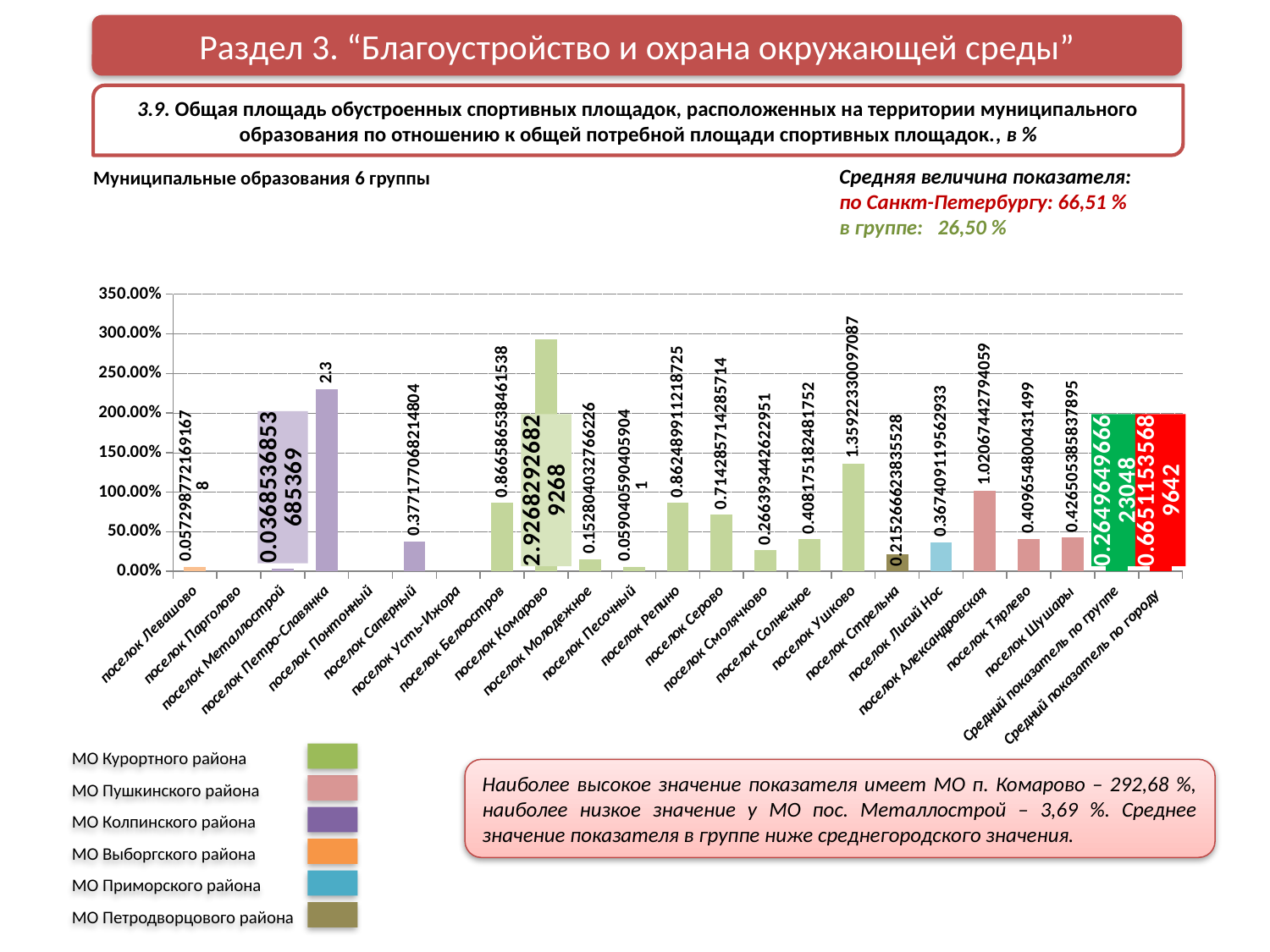
Which is larger, the value for поселок Петро-Славянка or the value for поселок Белоостров? поселок Петро-Славянка What data label is printed on the bar for поселок Петро-Славянка? 2.3 What data label is printed on the bar for поселок Ушково? 1.35922330097087 Which is larger, the value for поселок Ушково or the value for поселок Александровская? поселок Ушково How many district groups are listed in the colour legend below the chart? 6 Is the value for поселок Саперный greater or less than 50.00%? less What kind of chart is shown on the slide? bar chart How many categories are labelled along the x axis of the chart? 23 Which category has the highest bar in the chart? поселок Комарово Is the value for поселок Комарово greater or less than 250.00%? greater What data label is printed on the bar for поселок Саперный? 0.377177068214804 What data label is printed on the bar for поселок Серово? 0.714285714285714